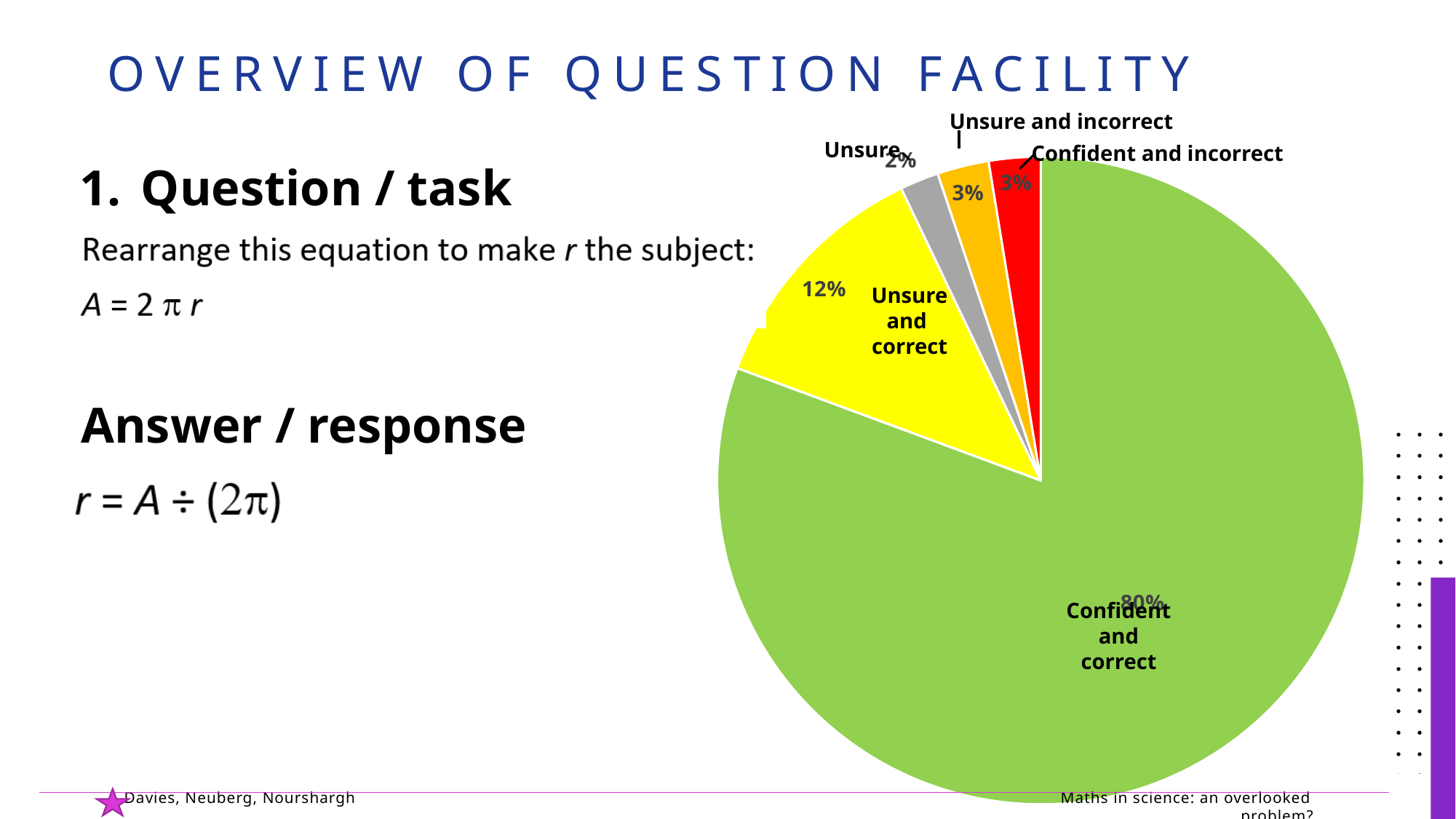
What is the difference in percentage points between 'Confident and correct' and 'Unsure and correct'? 68 Which category has the largest share of the pie chart? Confident and correct What colour is the 'Confident and incorrect' slice in the pie chart? Red Which is larger: the share for 'Unsure and correct' or the share for 'Unsure and incorrect'? Unsure and correct What percentage of responses were 'Unsure' in the pie chart? 2% How many slices does the pie chart have? 5 Which category has the smallest share of the pie chart? Unsure What percentage of responses were 'Confident and incorrect' in the pie chart? 3% What percentage of responses were 'Unsure and correct' in the pie chart? 12% What type of chart is shown on the slide? Pie chart What percentage of responses were 'Confident and correct' in the pie chart? 80% What colour is the 'Confident and correct' slice in the pie chart? Green